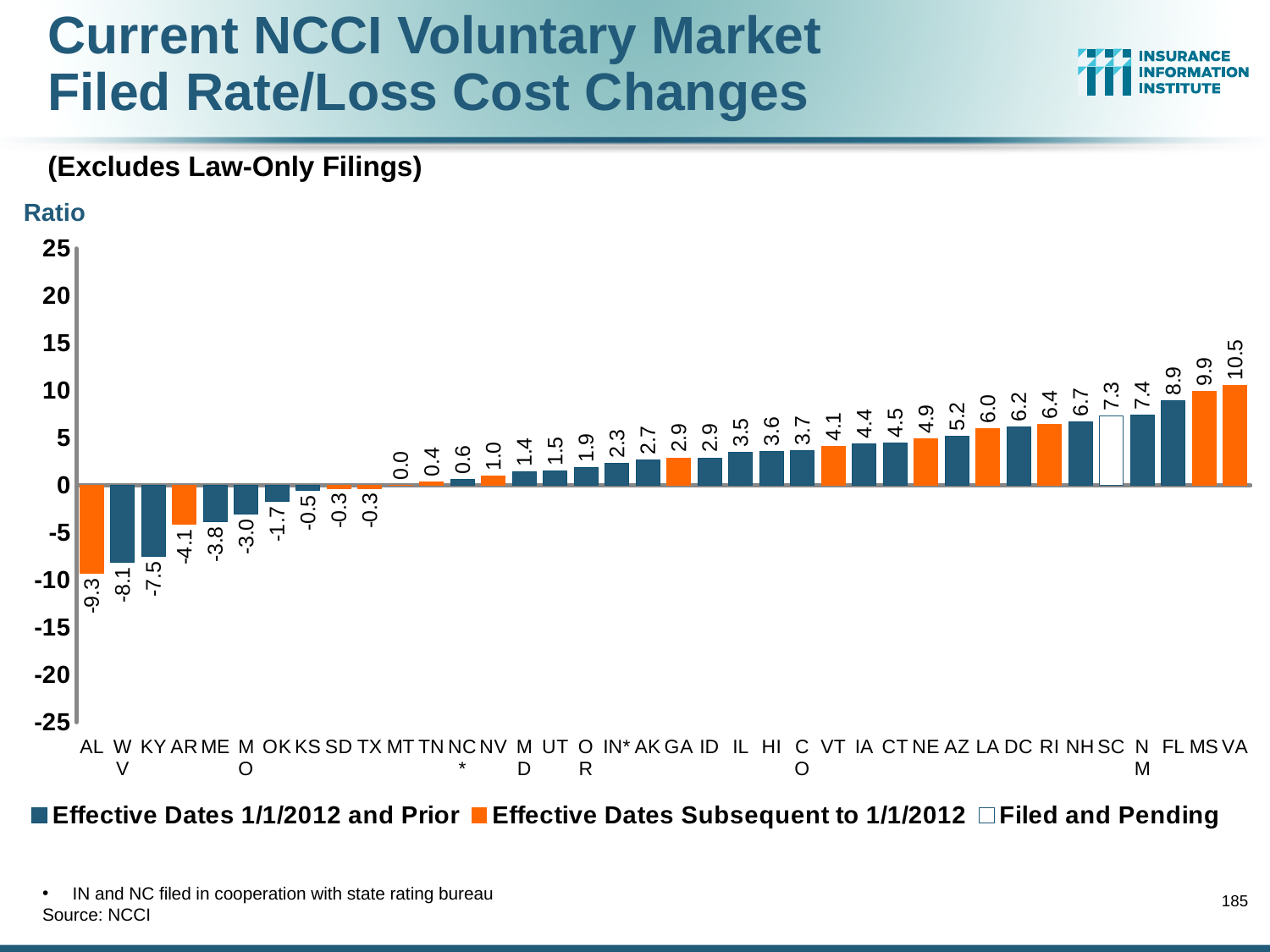
Do the values rise or fall from left to right along the x axis? Rise Which is larger, the value for FL or the value for MS? MS What is the value for MT? 0.0 What is the difference between the values for VA and AL? 19.8 What is the value for AL? -9.3 How many series does the legend list? 3 What is the value for SC? 7.3 What kind of chart is this? Bar chart What is the value for VA? 10.5 Which state has the highest value? VA How many states are shown on the x axis? 38 Which state has the lowest value? AL